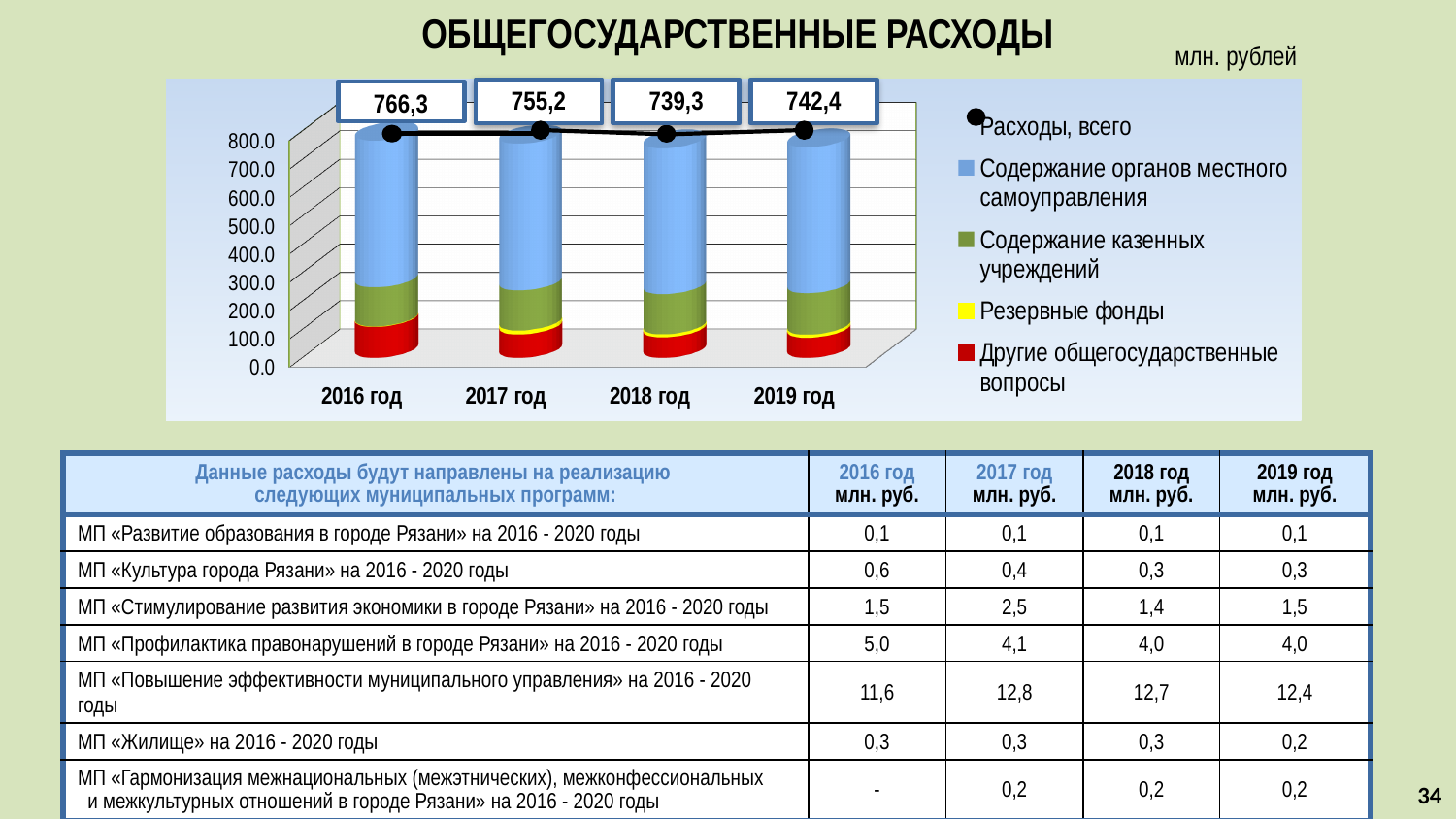
Is the value of «Расходы, всего» for 2019 год greater or less than 700? greater In which year is «Расходы, всего» the lowest? 2018 год Which year has the larger value of «Расходы, всего»: 2017 год or 2019 год? 2017 год What is the value of «Расходы, всего» for 2018 год? 739,3 How many years are shown on the x axis of the chart? 4 What is the difference between «Расходы, всего» in 2017 год and 2018 год? 15,9 What kind of chart is shown on the slide? bar chart Does «Расходы, всего» rise or fall from 2016 год to 2018 год? fall What is the value of «Расходы, всего» for 2016 год? 766,3 How many entries does the chart legend list? 5 In which year is «Расходы, всего» the highest? 2016 год What is the difference between «Расходы, всего» in 2016 год and 2019 год? 23,9